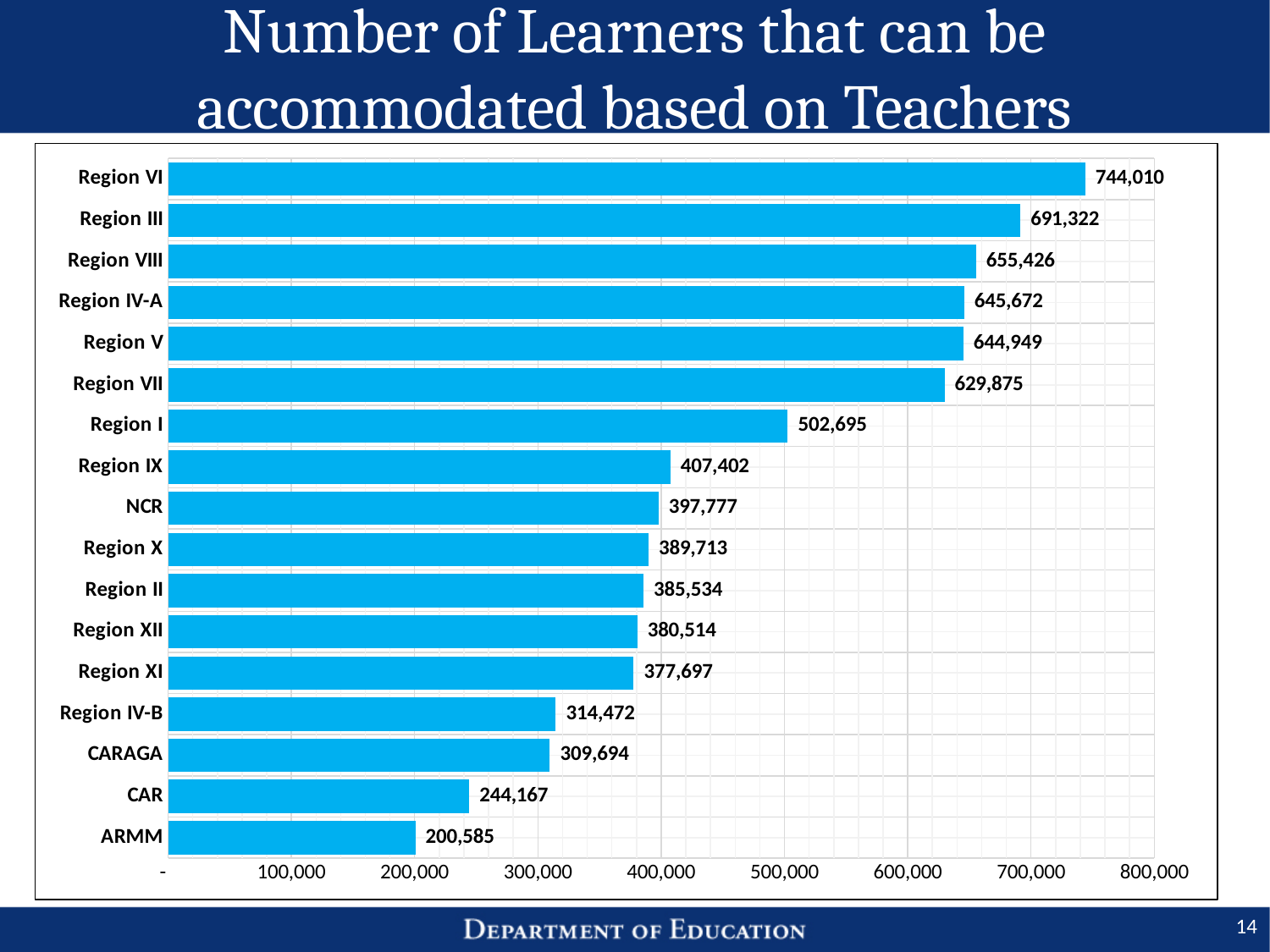
What is the title of the chart on the slide? Number of Learners that can be accommodated based on Teachers Is the value for Region VII greater or less than 600,000? greater What is the difference between the values for CAR and ARMM? 43,582 How many regions are shown in the chart? 17 Which region has the highest number of learners that can be accommodated? Region VI What is the value shown for CARAGA? 309,694 Which has a larger value, Region I or Region IX? Region I Which region has the lowest number of learners that can be accommodated? ARMM What is the difference between the values for Region VI and Region III? 52,688 What is the number of learners that can be accommodated for Region VI? 744,010 What is the value shown for NCR? 397,777 What kind of chart is shown on the slide? Bar chart